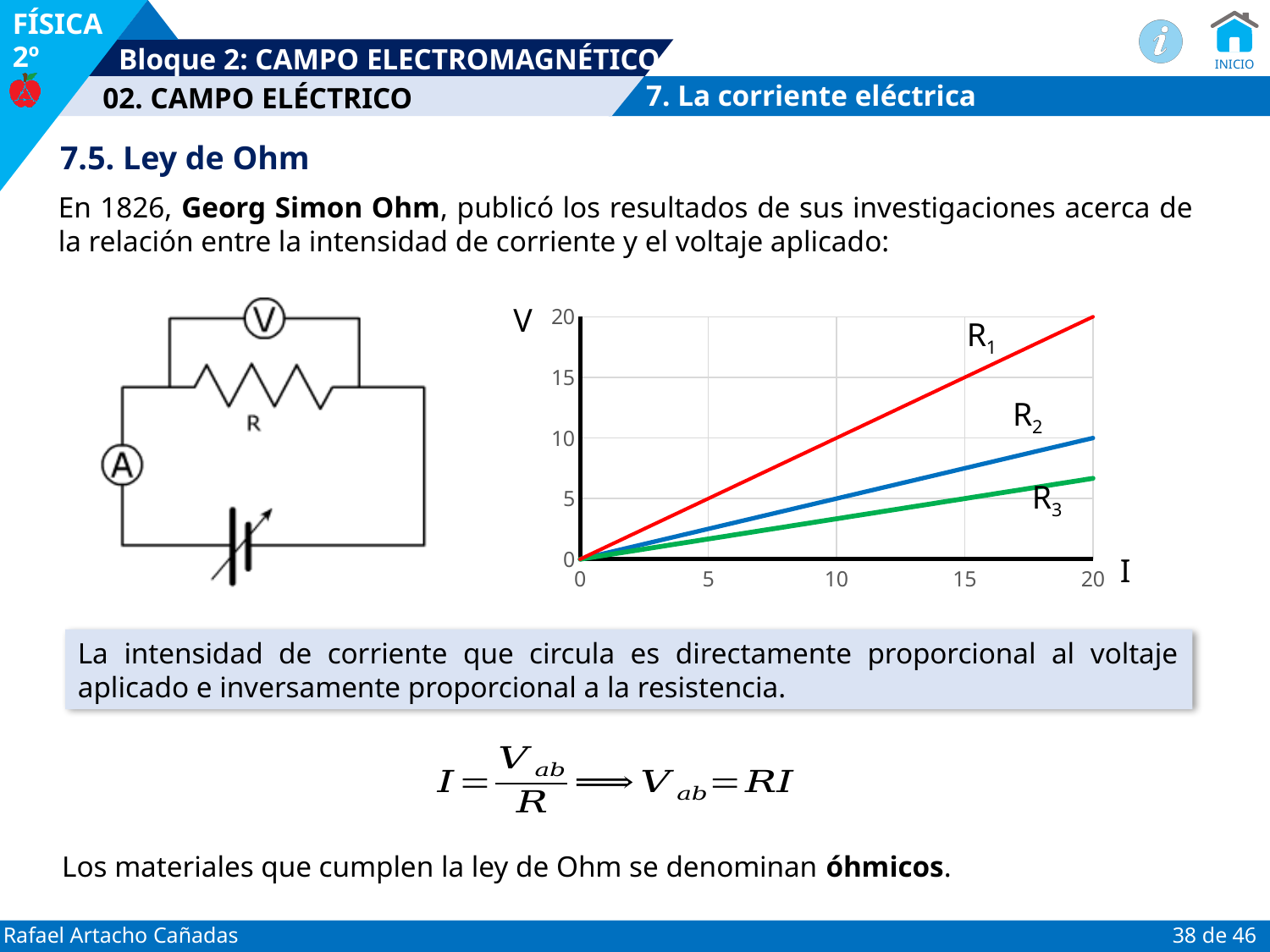
At I = 10, which line has the larger value of V, R1 or R2? R1 Which line has the smallest slope on the chart? R3 Is the value of V for R3 at I = 20 greater or less than 10? less Is the value of V for R1 at I = 20 greater or less than 15? greater Which line has the steepest slope on the chart? R1 What is the label of the vertical axis of the chart? V How many lines are plotted on the chart? 3 Is the value of V for R1 at I = 10 greater or less than 5? greater What is the highest value shown on the horizontal axis of the chart? 20 What kind of chart is shown on the slide? line chart Do the values of V rise or fall as I increases along the x axis? rise